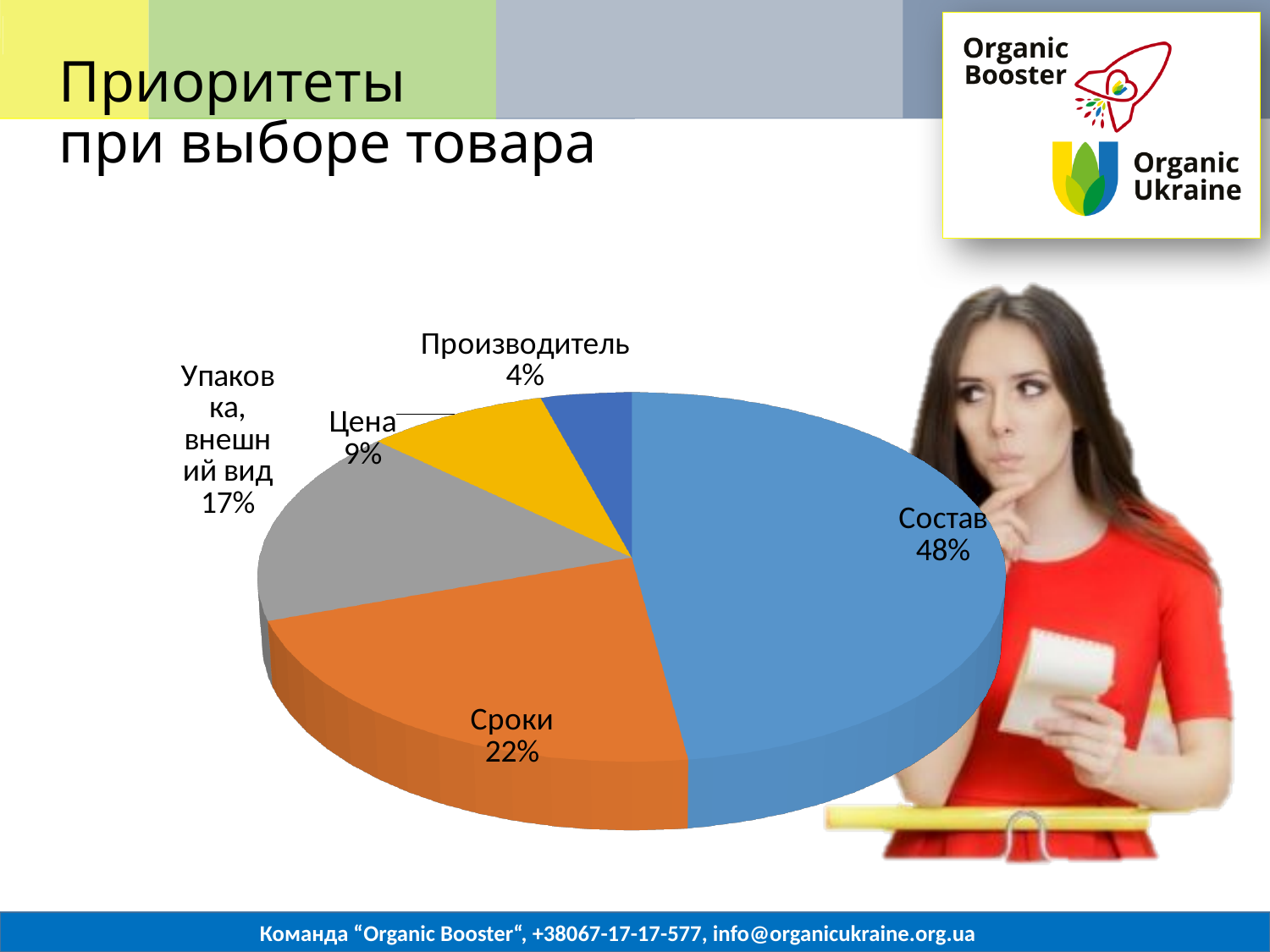
Which category has the largest slice of the pie? Состав How many categories are shown in the pie chart? 5 Which is larger, Цена or Упаковка, внешний вид? Упаковка, внешний вид What share of the pie does Состав have? 48% What share of the pie does Упаковка, внешний вид have? 17% What is the difference in percentage points between Состав and Сроки? 26 What share of the pie does Цена have? 9% What kind of chart is shown on the slide? Pie chart Which category has the smallest slice of the pie? Производитель What share of the pie does Сроки have? 22% What colour is the Состав slice? Blue What share of the pie does Производитель have? 4%